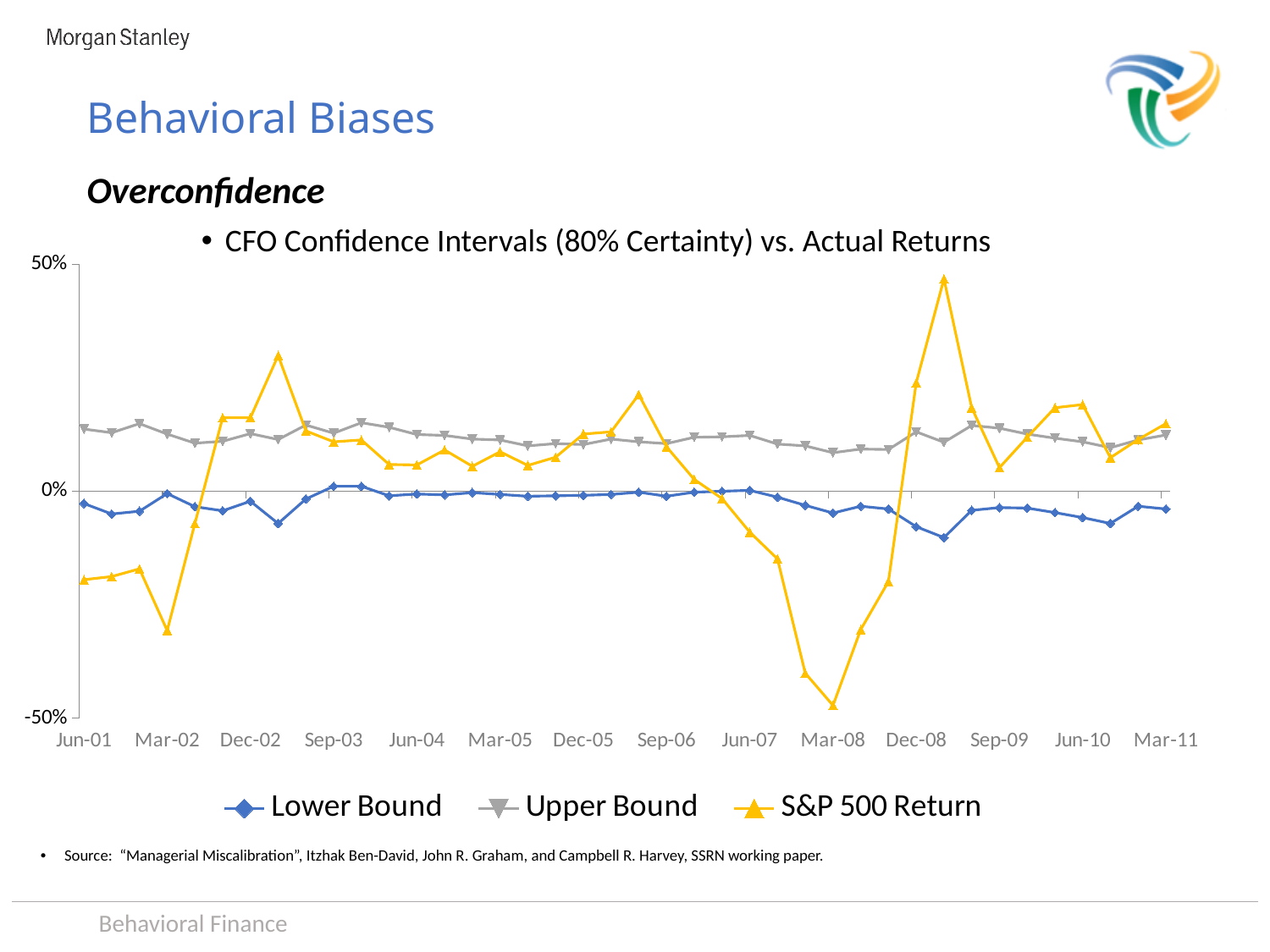
At Mar-08, which is larger: the Upper Bound or the S&P 500 Return? Upper Bound Does the S&P 500 Return rise or fall between Jun-07 and Mar-08? fall What kind of chart is shown on the slide? line chart How many series does the legend list? 3 How many date labels are shown on the x axis? 14 What is the title of the chart? CFO Confidence Intervals (80% Certainty) vs. Actual Returns Is the S&P 500 Return value at Mar-08 greater or less than 0%? less Which series reaches the highest value anywhere on the chart? S&P 500 Return What are the three series listed in the legend? Lower Bound, Upper Bound, S&P 500 Return Is the Upper Bound value at Jun-01 greater or less than 0%? greater Is the Lower Bound value at Jun-01 greater or less than 0%? less At which labeled date does the S&P 500 Return reach its lowest value? Mar-08